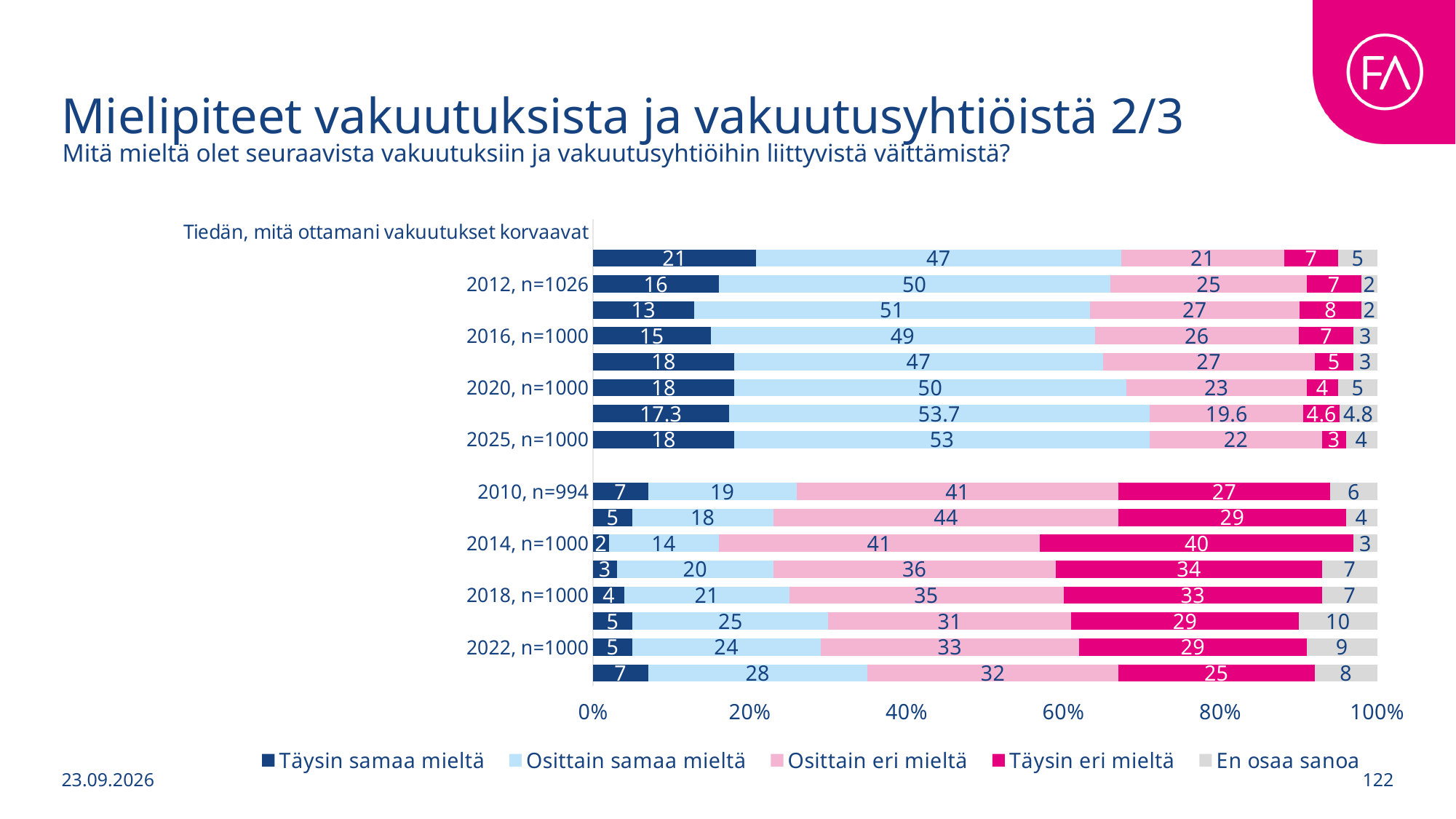
Which is larger: the Täysin eri mieltä value in the bar labelled 2014, n=1000 or in the bar labelled 2018, n=1000? 2014, n=1000 In the bar labelled 2012, n=1026, what is the value for Osittain samaa mieltä? 50 Which segment is the largest in the bar labelled 2020, n=1000? Osittain samaa mieltä In the bar labelled 2014, n=1000, what is the value for Täysin eri mieltä? 40 In the bar labelled 2010, n=994, what is the value for Osittain eri mieltä? 41 Which segment is the smallest in the bar labelled 2014, n=1000? Täysin samaa mieltä How many series does the legend list? 5 In the bar labelled 2025, n=1000, what is the value for Täysin samaa mieltä? 18 In the bar labelled 2022, n=1000, what is the value for En osaa sanoa? 9 What is the last entry in the chart legend? En osaa sanoa What is the difference between the Osittain samaa mieltä values in the bars labelled 2025, n=1000 and 2016, n=1000? 4 What kind of chart is shown on the slide? Stacked bar chart